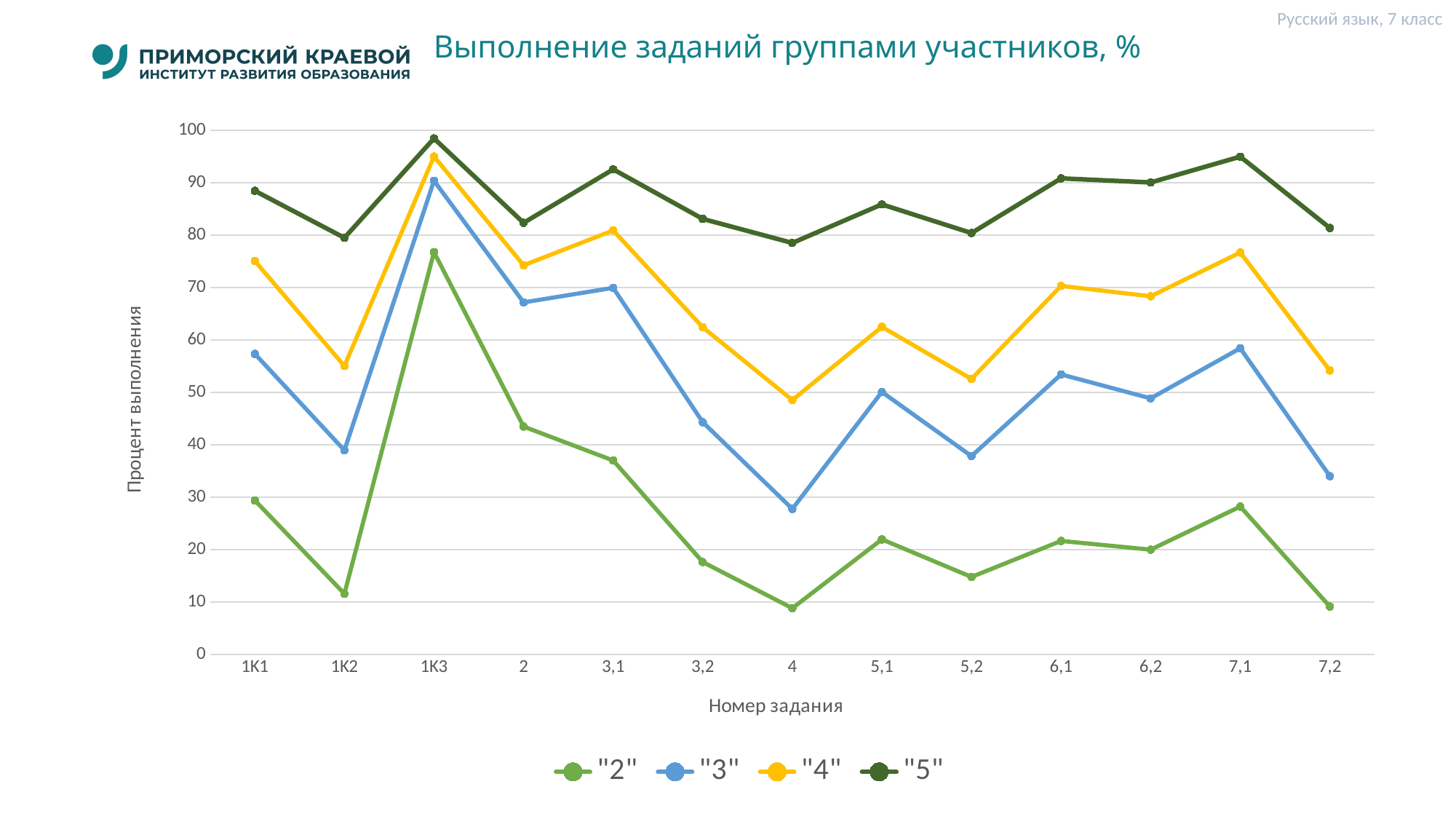
Does the "2" series rise or fall from task 1К3 to task 4? fall For which task does the "3" series reach its lowest value? 4 For the "3" series, which is larger: the value at task 1К1 or at task 1К2? 1К1 Is the value for the "5" series at task 1К1 greater or less than 80? greater Is the value for the "2" series at task 1К2 greater or less than 20? less Is the value for the "4" series at task 7,1 greater or less than 70? greater For which task does the "2" series reach its highest value? 1К3 How many series does the legend list? 4 How many task numbers are shown along the x axis? 13 For which task does the "4" series reach its lowest value? 4 What kind of chart is shown on the slide? line chart